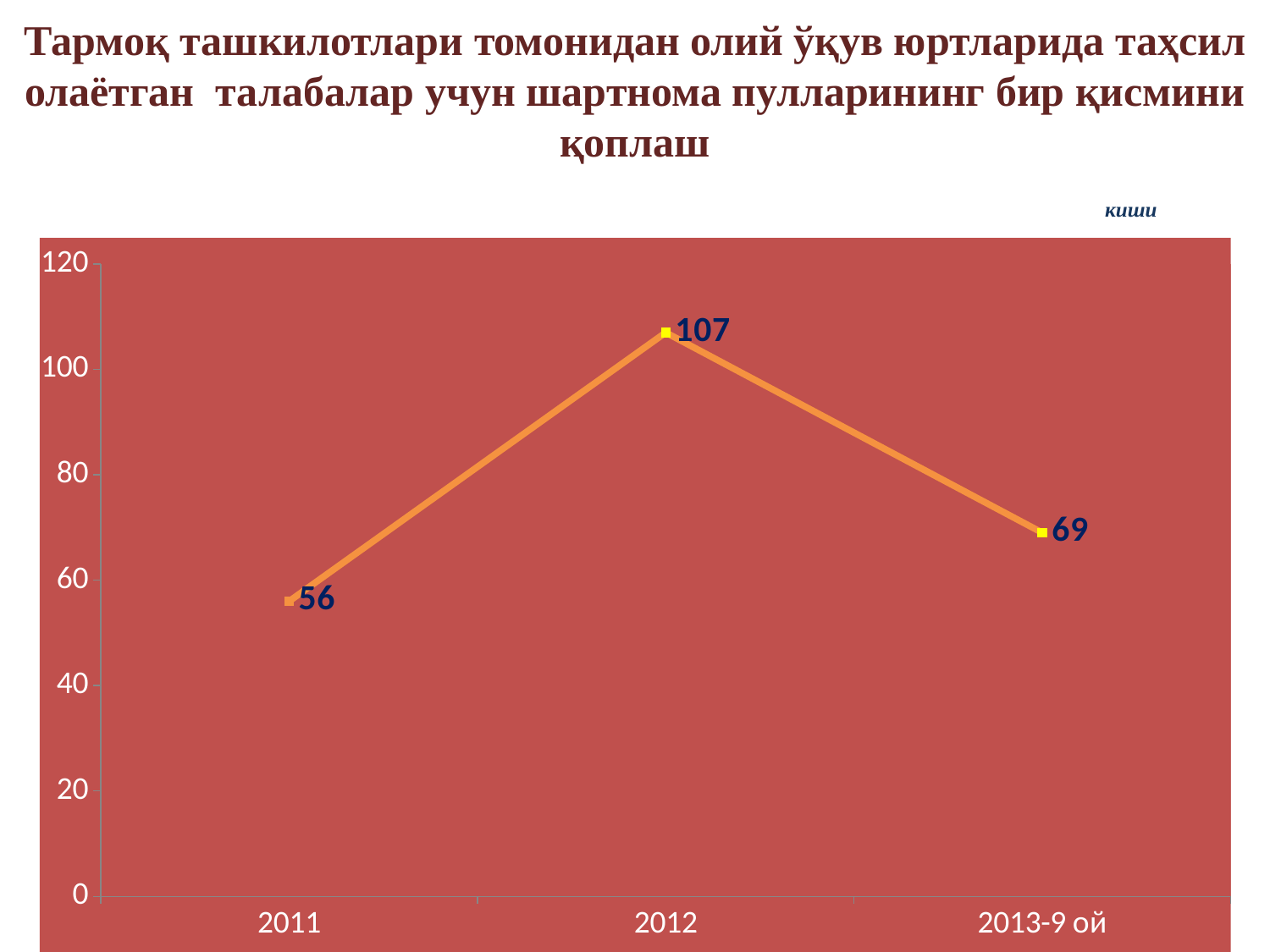
Which category has the lowest value? 2011 What is the difference between the values for 2012 and 2011? 51 Which is larger, the value for 2013-9 ой or the value for 2011? 2013-9 ой What kind of chart is shown on the slide? line chart What is the value for 2011? 56 What is the value for 2013-9 ой? 69 Is the value for 2012 greater or less than 100? greater What is the value for 2012? 107 What is the difference between the values for 2012 and 2013-9 ой? 38 Which category has the highest value? 2012 How many data points are plotted on the chart? 3 What unit label is shown above the top right of the chart? киши